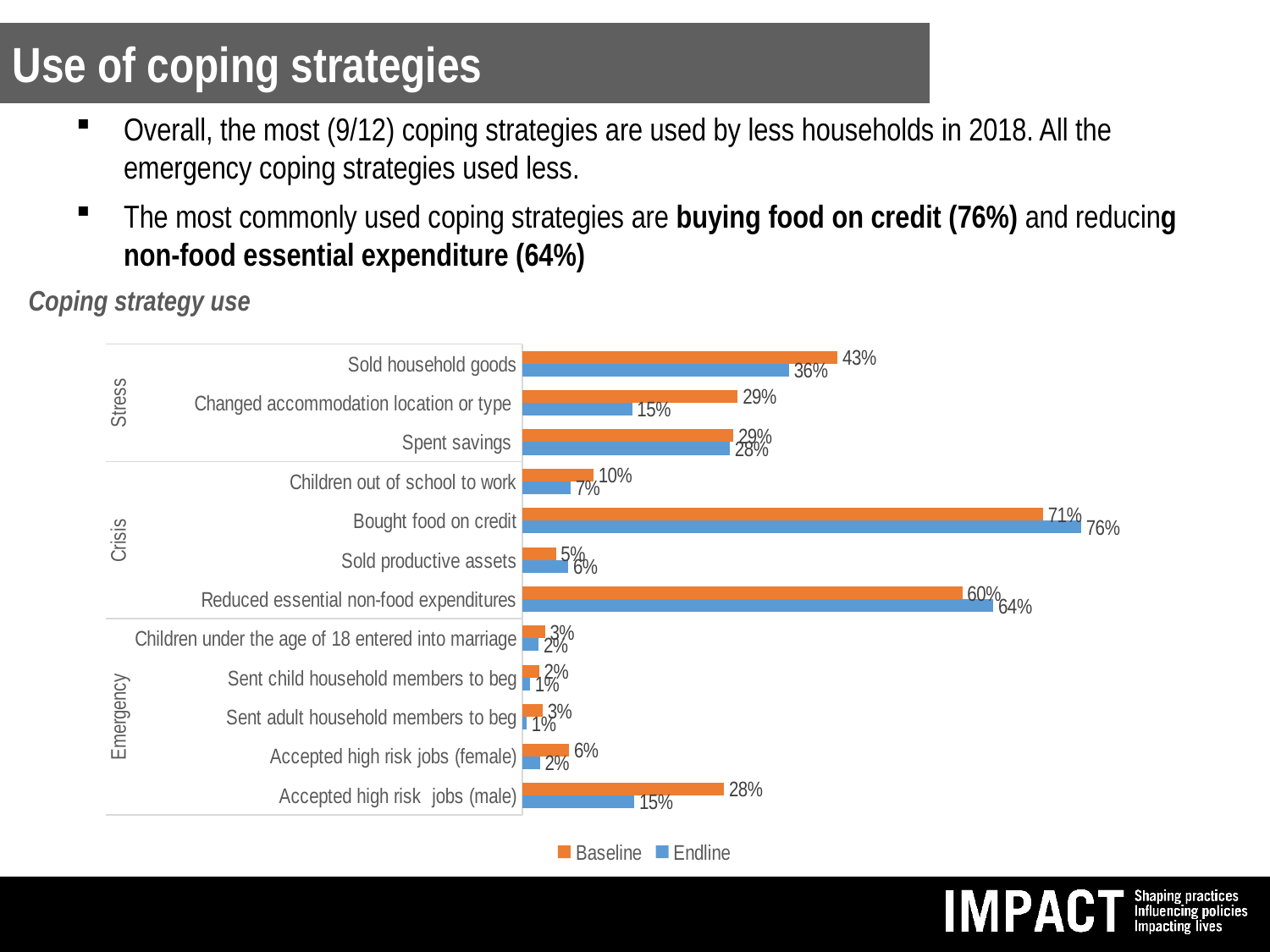
Which is larger for Accepted high risk jobs (female): the Baseline value or the Endline value? Baseline How many series does the legend list? 2 What is the Baseline value for Sold household goods? 43% What kind of chart is shown on the slide? Bar chart How many coping strategies are listed in the chart? 12 What is the Endline value for Bought food on credit? 76% Which colour represents the Endline series in the chart? Blue What is the difference between the Baseline and Endline values for Reduced essential non-food expenditures? 4% Which coping strategy has the highest Endline value? Bought food on credit Which coping strategy has the lowest Baseline value? Sent child household members to beg What is the Endline value for Changed accommodation location or type? 15% What is the Baseline value for Accepted high risk jobs (male)? 28%